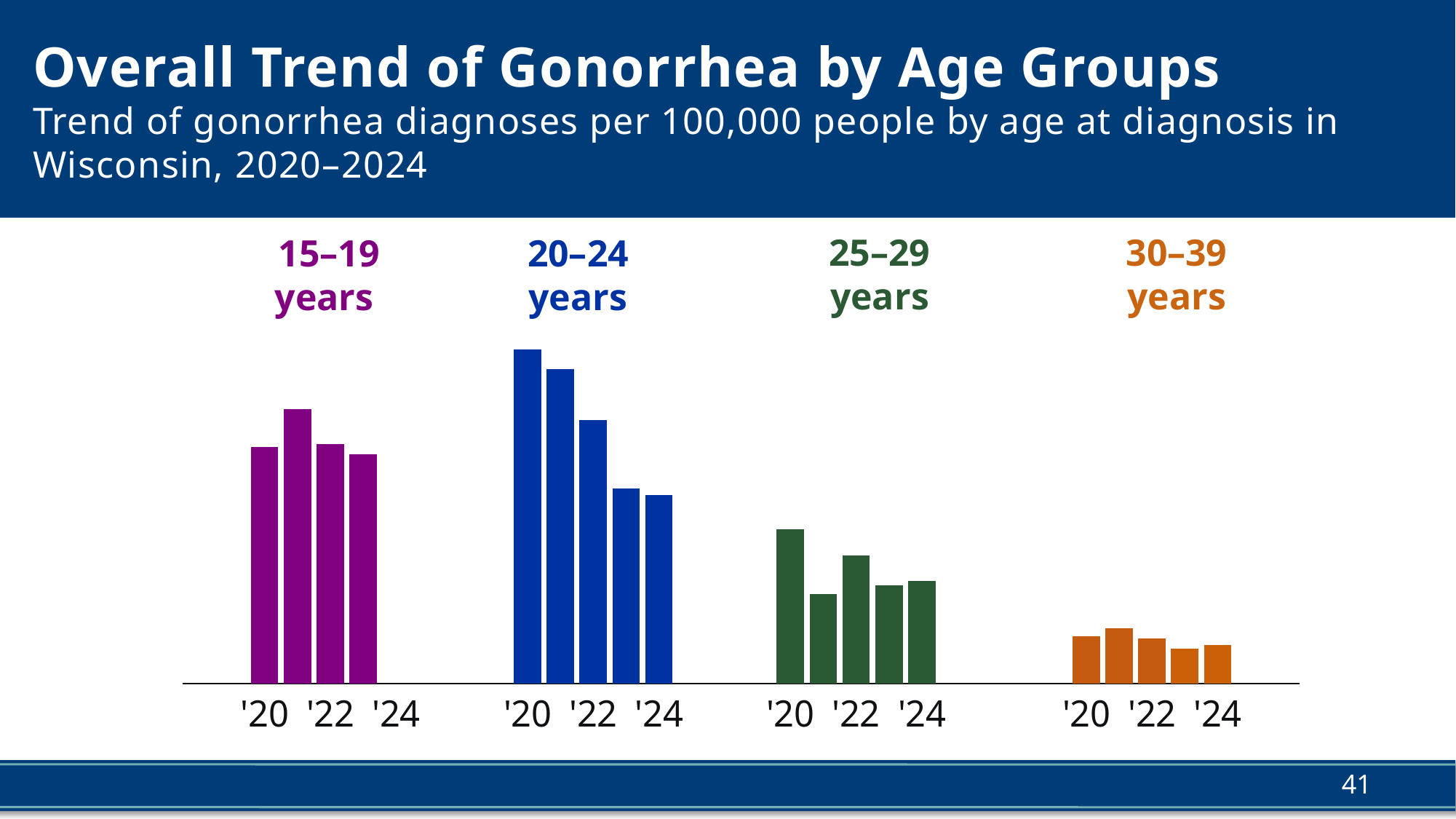
In the 20–24 years group, which year has the lowest bar? '24 How many age groups are shown in the chart? 4 Which is larger: the 2022 bar for 20–24 years or the 2020 bar for 25–29 years? 2022 bar for 20–24 years Which age group has the highest gonorrhea diagnosis rate in the chart? 20–24 years In the 20–24 years group, which year has the highest bar? '20 How many bars are plotted for the 20–24 years age group? 5 What kind of chart is shown on the slide? bar chart In the 25–29 years group, which year has the highest bar? '20 For the 20–24 years group, do the values rise or fall from 2020 to 2024? fall Which age group has the lowest gonorrhea diagnosis rates in the chart? 30–39 years Which is larger in 2020: the rate for 20–24 years or for 25–29 years? 20–24 years What colour are the bars for the 30–39 years age group? orange